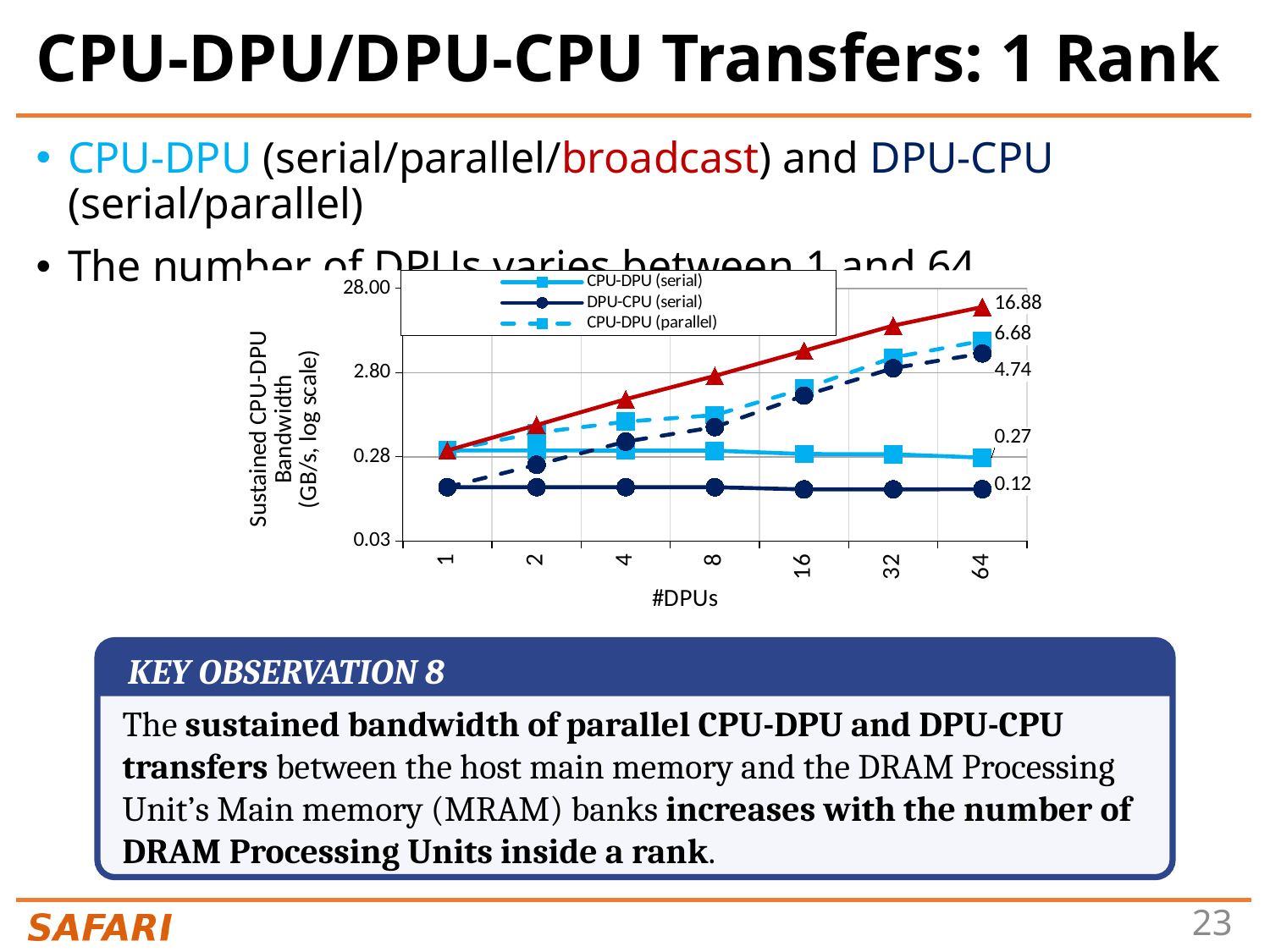
Is the value for DPU-CPU (serial) at 1 DPU greater or less than 0.28? less At 64 DPUs, what is the difference between the CPU-DPU (serial) value and the DPU-CPU (serial) value? 0.15 What is the value for CPU-DPU (parallel) at 64 DPUs? 6.68 At 64 DPUs, which is larger: CPU-DPU (parallel) or CPU-DPU (serial)? CPU-DPU (parallel) What kind of chart is shown on the slide? line chart What is the value for CPU-DPU (serial) at 64 DPUs? 0.27 How many #DPUs values are shown on the x axis? 7 What is the label of the x axis? #DPUs Is the value for CPU-DPU (parallel) at 16 DPUs greater or less than 0.28? greater What is the highest data label printed on the chart? 16.88 Does the CPU-DPU (parallel) bandwidth rise or fall as the number of DPUs increases? rises What is the value for DPU-CPU (serial) at 64 DPUs? 0.12